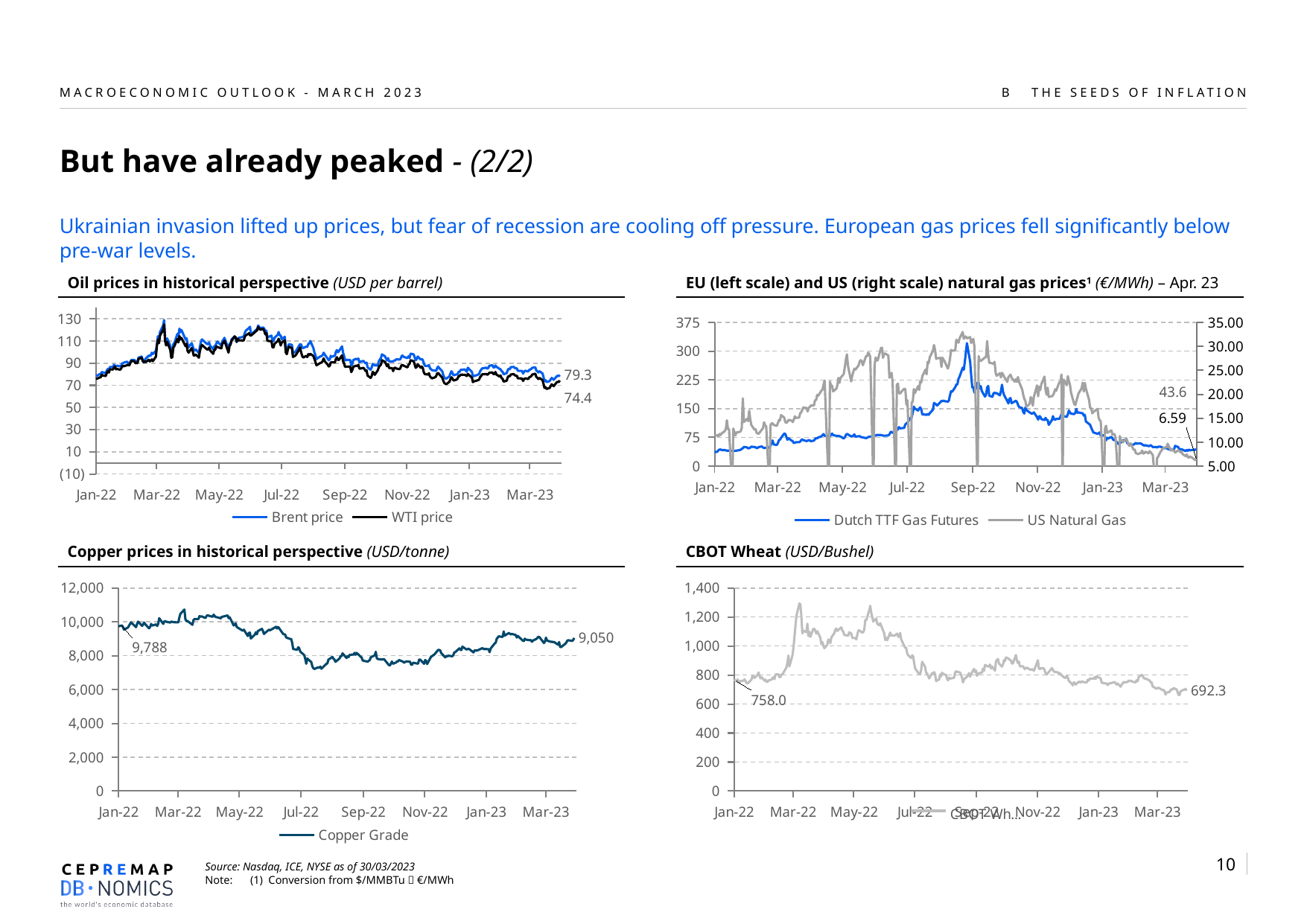
In the 'EU (left scale) and US (right scale) natural gas prices' chart, what is the labelled end value of the US Natural Gas series? 6.59 In the 'CBOT Wheat' chart, what is the difference between the labelled start value and the labelled end value? 65.7 In the 'Oil prices in historical perspective' chart, what is the latest labelled value of the WTI price? 74.4 What kind of chart is the 'CBOT Wheat' chart? Line chart In the 'Oil prices in historical perspective' chart, which series has the higher labelled end value, Brent price or WTI price? Brent price In the 'Oil prices in historical perspective' chart, what is the difference between the labelled end values of the Brent price and the WTI price? 4.9 In the 'Copper prices in historical perspective' chart, what is the labelled value at the end of the series? 9,050 In the 'Copper prices in historical perspective' chart, what is the difference between the labelled start value (9,788) and the labelled end value (9,050)? 738 In the 'EU (left scale) and US (right scale) natural gas prices' chart, what is the labelled end value of the Dutch TTF Gas Futures series? 43.6 In the 'Oil prices in historical perspective' chart, what is the latest labelled value of the Brent price? 79.3 In the 'Copper prices in historical perspective' chart, what is the labelled value at the start of the series in Jan-22? 9,788 How many series does the legend of the 'Oil prices in historical perspective' chart list? 2